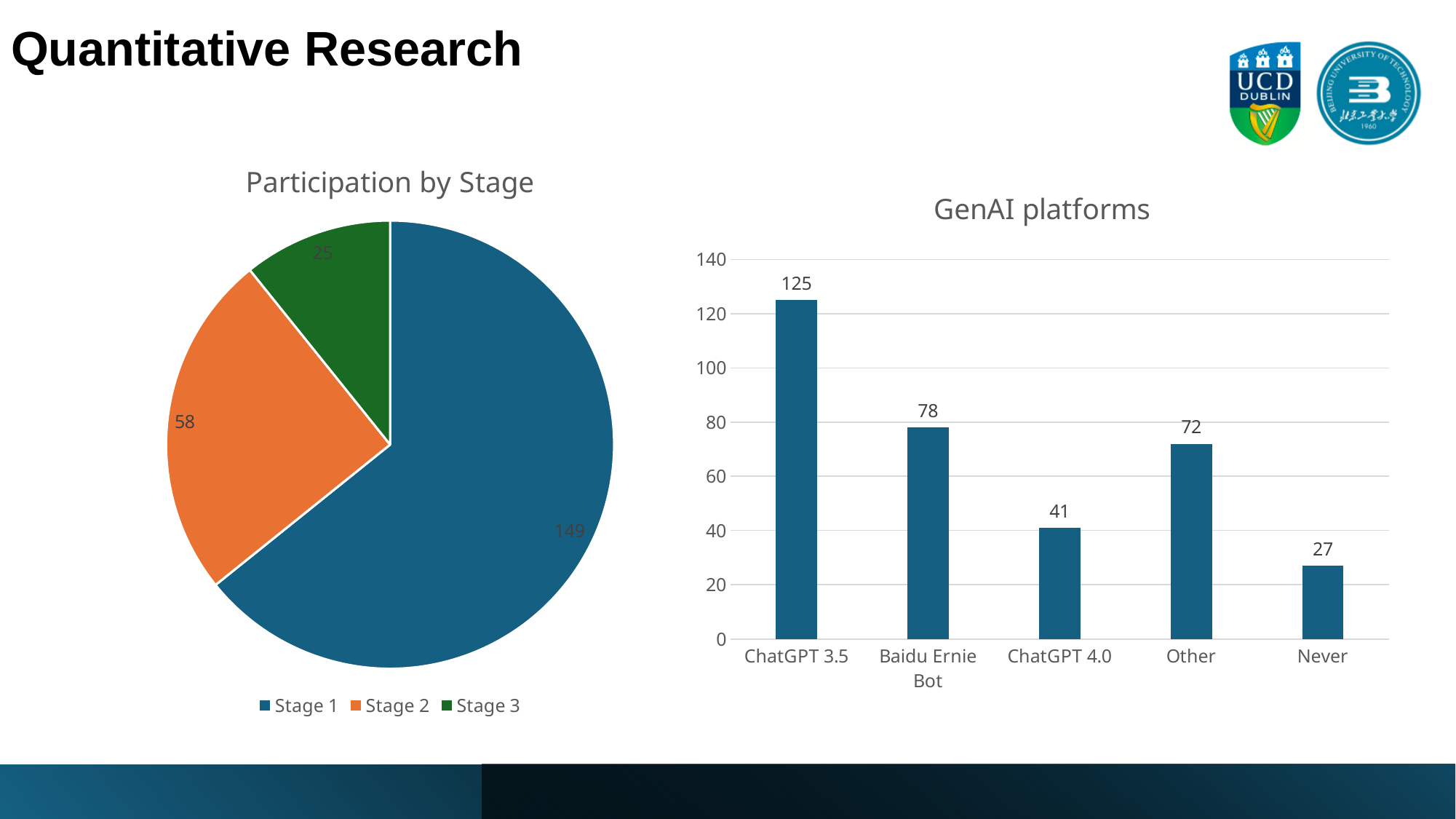
In the GenAI platforms chart, what is the difference between ChatGPT 3.5 and ChatGPT 4.0? 84 How many categories are shown in the GenAI platforms chart? 5 How many entries does the legend of the Participation by Stage chart list? 3 In the GenAI platforms chart, which platform has the highest value? ChatGPT 3.5 In the GenAI platforms chart, which category has the lowest value? Never In the GenAI platforms chart, what is the value for Baidu Ernie Bot? 78 What kind of chart is the Participation by Stage chart? Pie chart In the Participation by Stage chart, what is the value for Stage 3? 25 In the GenAI platforms chart, which is larger, Baidu Ernie Bot or Other? Baidu Ernie Bot In the Participation by Stage chart, what is the difference between Stage 1 and Stage 2? 91 In the Participation by Stage chart, what is the value for Stage 1? 149 In the Participation by Stage chart, which stage has the smallest slice? Stage 3